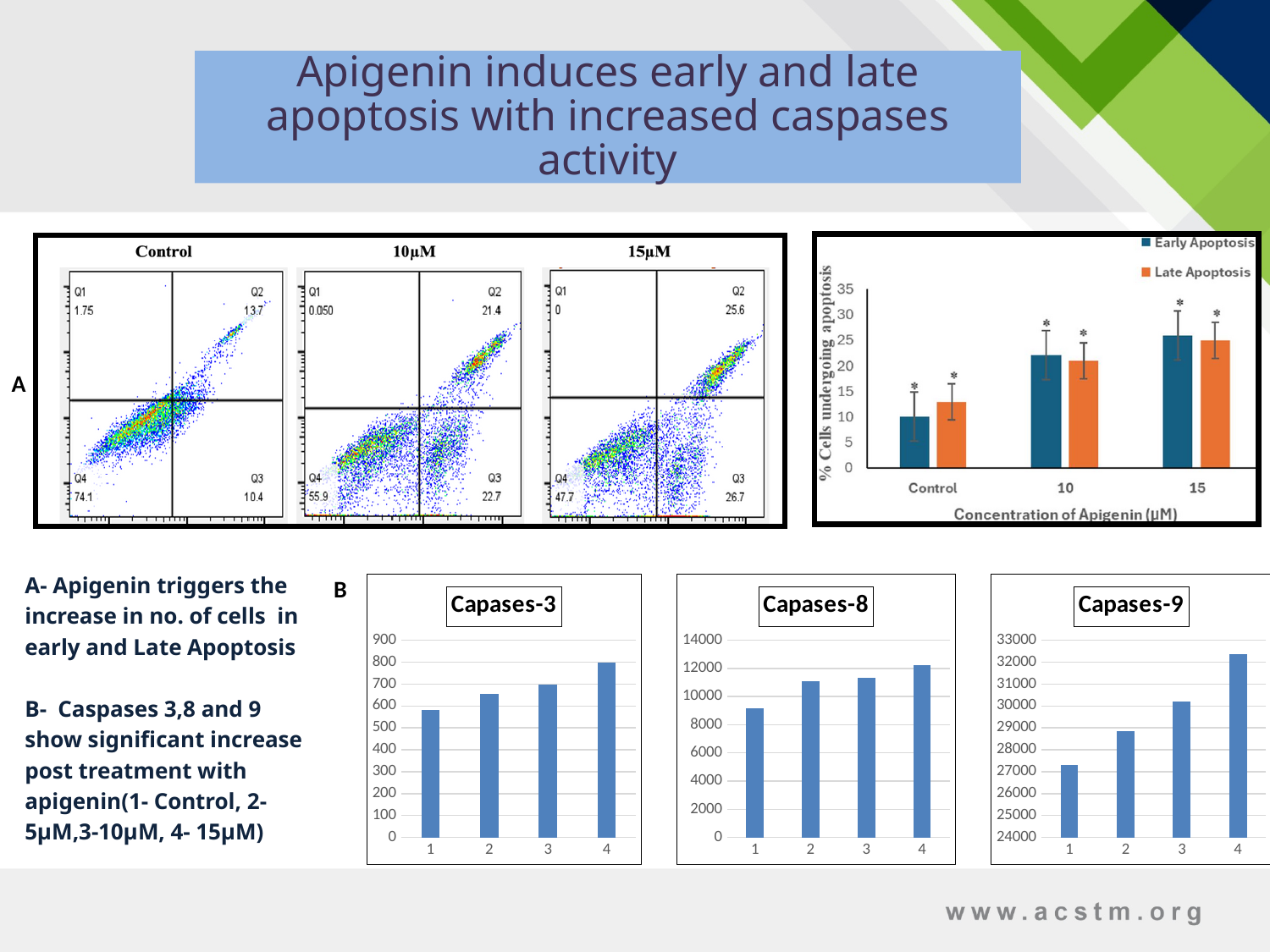
How many series does the legend of the apoptosis chart (top right) list? 2 In the apoptosis chart (top right), is the Early Apoptosis value at 10 µM greater or less than 20? greater In the Capases-3 chart, is the value for category 1 greater or less than 500? greater How many concentration categories are shown on the x axis of the apoptosis chart (top right)? 3 In the Capases-9 chart, is the value for category 4 greater or less than 32000? greater In the apoptosis chart (top right), at which concentration is Early Apoptosis highest? 15 What kind of chart is the Capases-3 chart? bar chart In the apoptosis chart (top right), which is larger for Control: Early Apoptosis or Late Apoptosis? Late Apoptosis In the Capases-3 chart, which category has the lowest value? 1 In the Capases-9 chart, do the values rise or fall from category 1 to category 4? rise